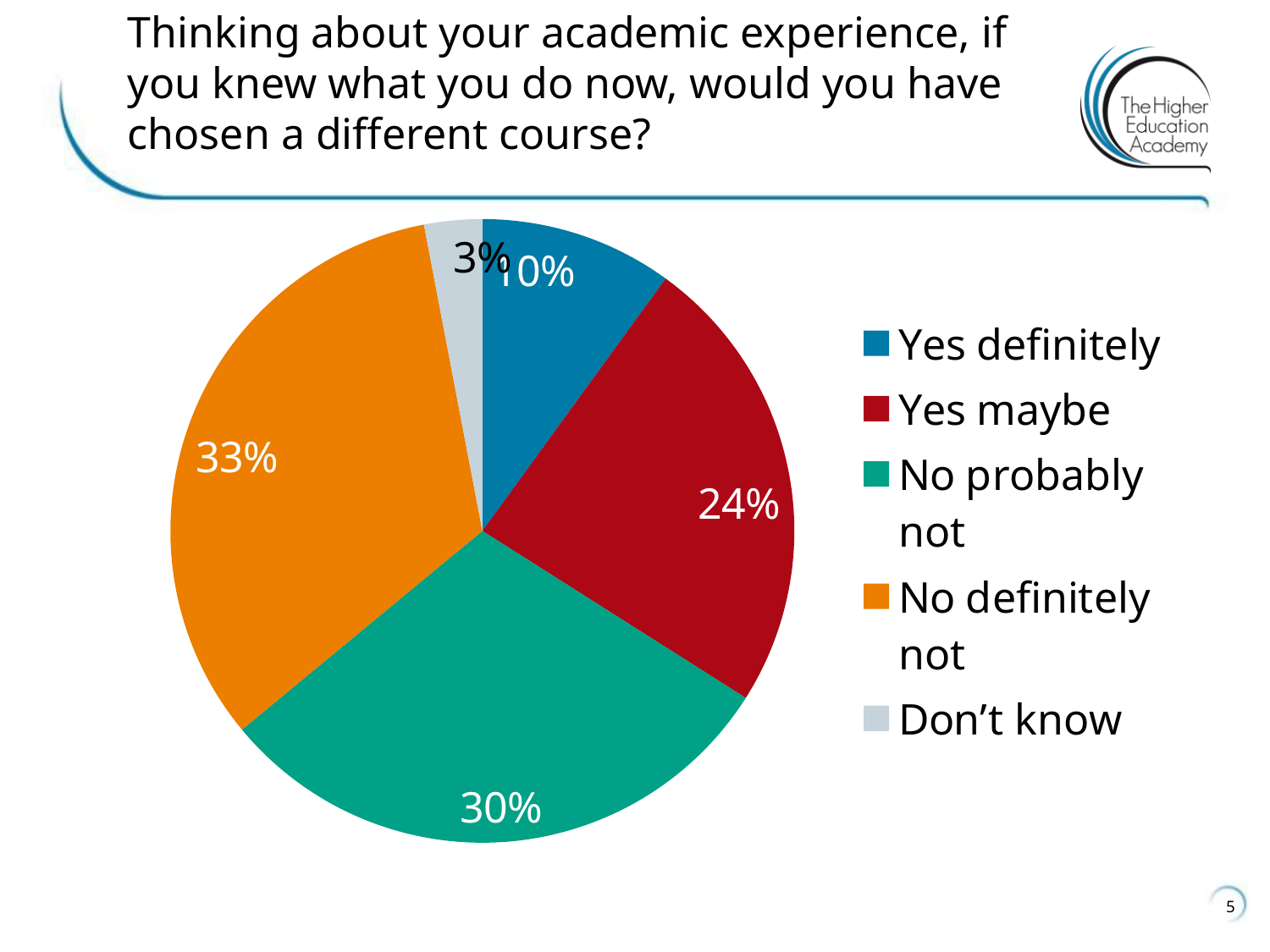
What kind of chart is shown on the slide? pie chart What share of the pie is 'Yes definitely'? 10% What share of the pie is 'Yes maybe'? 24% What colour is the slice for 'No probably not'? green What share of the pie is 'No probably not'? 30% How many categories does the pie chart have? 5 Which is larger, the slice for 'Yes maybe' or the slice for 'No probably not'? No probably not What is the difference in percentage points between 'No definitely not' and 'Yes maybe'? 9 Which category has the largest slice of the pie? No definitely not Which category has the smallest slice of the pie? Don't know